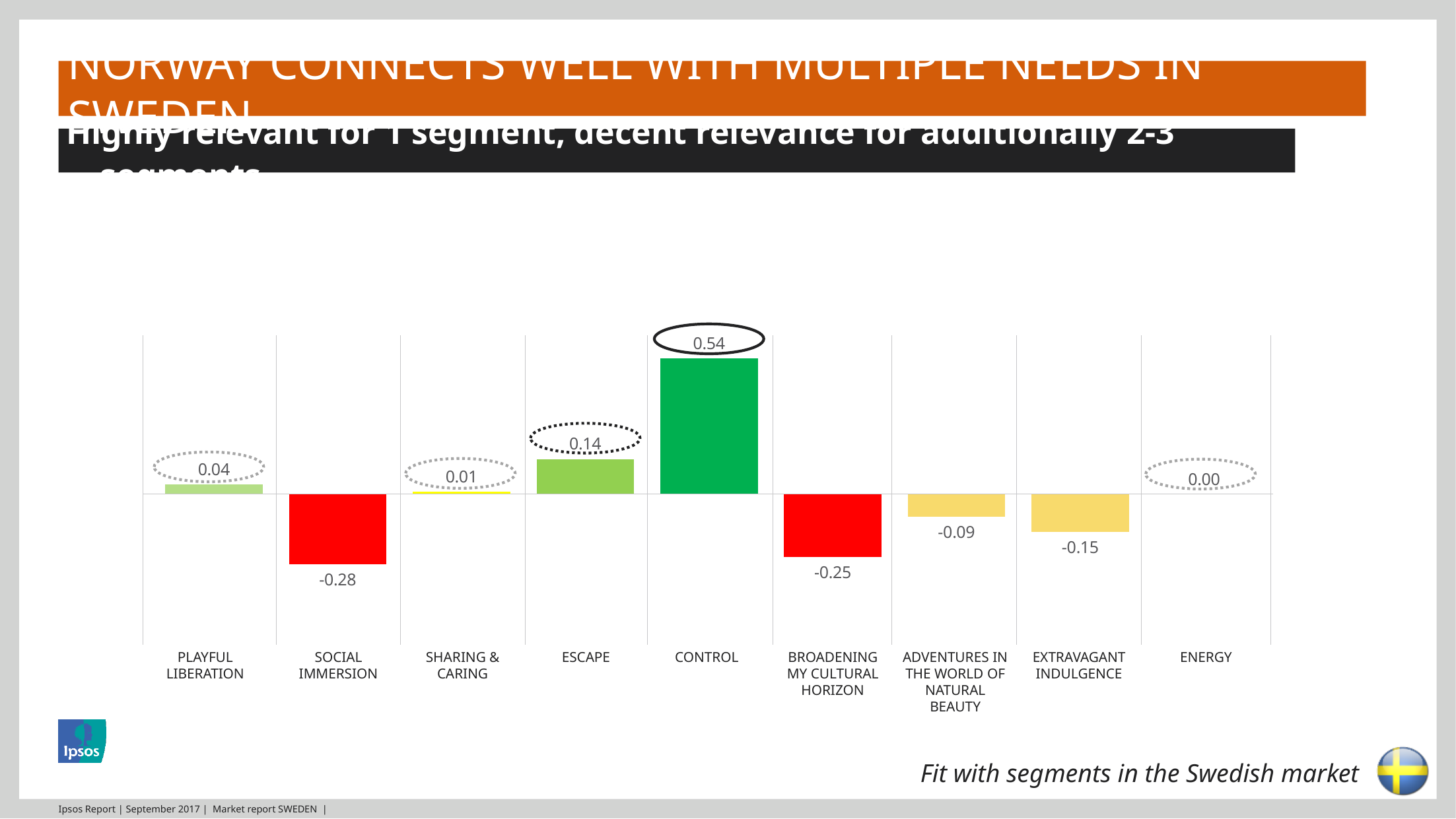
What is the value for SOCIAL IMMERSION? -0.28 Which category has the highest value? CONTROL Which is larger, the value for PLAYFUL LIBERATION or the value for SHARING & CARING? PLAYFUL LIBERATION What is the value for CONTROL? 0.54 What is the difference between the values for BROADENING MY CULTURAL HORIZON and ADVENTURES IN THE WORLD OF NATURAL BEAUTY? 0.16 What is the value for ESCAPE? 0.14 What kind of chart is shown on the slide? Bar chart What is the difference between the values for CONTROL and ESCAPE? 0.40 What is the value for EXTRAVAGANT INDULGENCE? -0.15 How many categories are shown on the x axis? 9 Which category has the lowest value? SOCIAL IMMERSION What is the value for ENERGY? 0.00